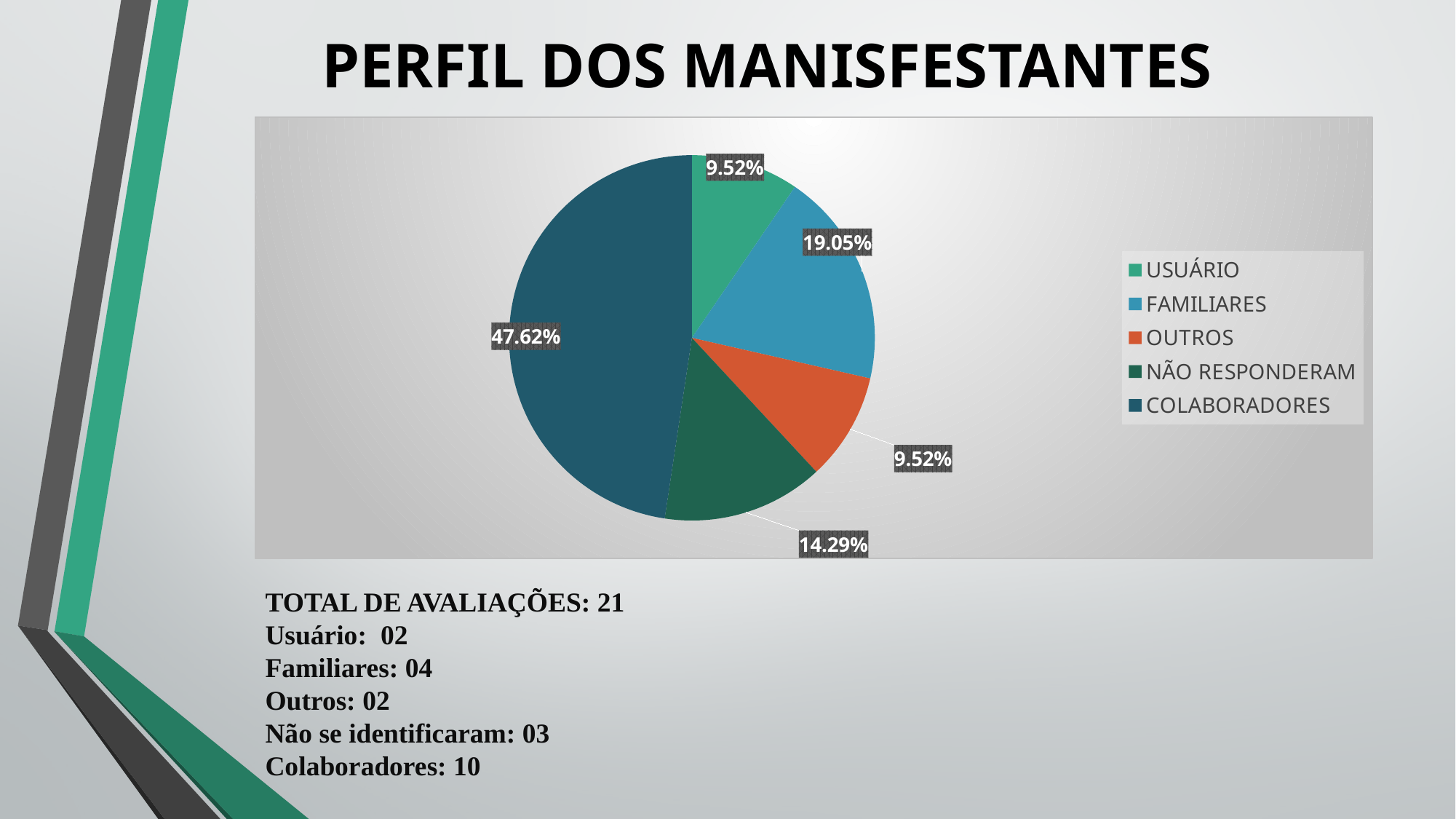
Which legend entry is shown in orange? OUTROS Which category has the largest slice of the pie? COLABORADORES How many slices does the pie chart have? 5 What is the title of the slide containing the pie chart? PERFIL DOS MANISFESTANTES What share of the pie does NÃO RESPONDERAM represent? 14.29% What is the difference in percentage points between the COLABORADORES slice and the FAMILIARES slice? 28.57 How many entries does the legend of the pie chart list? 5 What share of the pie does FAMILIARES represent? 19.05% What share of the pie does COLABORADORES represent? 47.62% What kind of chart is shown on the slide? pie chart Which is larger, the slice for FAMILIARES or the slice for NÃO RESPONDERAM? FAMILIARES